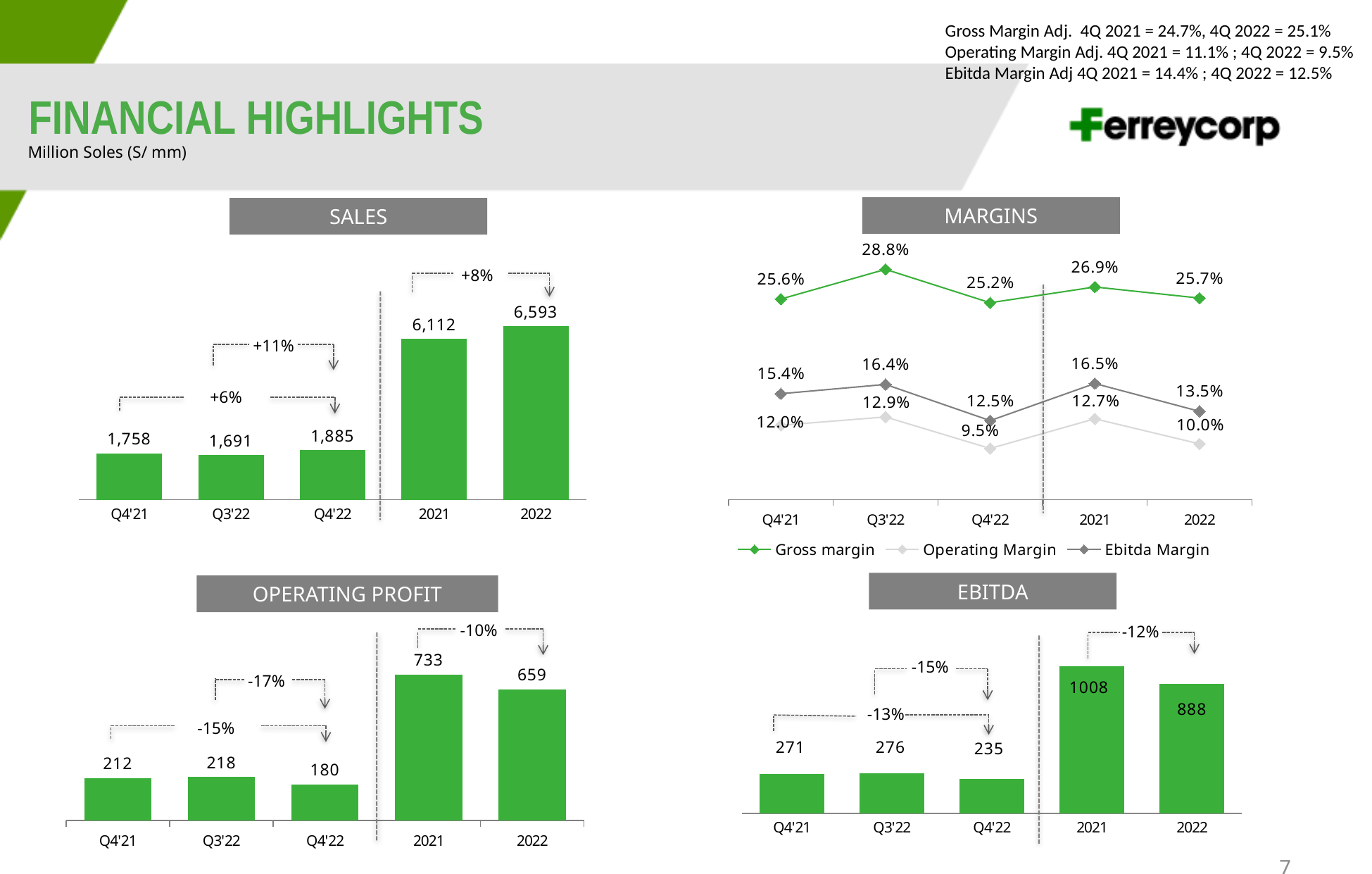
In the OPERATING PROFIT chart, what is the value for Q4'22? 180 In the EBITDA chart, what is the value for 2021? 1008 In the OPERATING PROFIT chart, which is larger, the value for 2021 or 2022? 2021 What kind of chart is the MARGINS chart? Line chart In the SALES chart, what is the value for 2022? 6,593 In the MARGINS chart, what is the Gross margin for Q3'22? 28.8% How many categories are shown on the x axis of the EBITDA chart? 5 In the MARGINS chart, what is the Operating Margin for Q4'22? 9.5% In the SALES chart, what is the difference between the 2022 and 2021 values? 481 How many series does the legend of the MARGINS chart list? 3 In the EBITDA chart, what is the difference between the Q3'22 and Q4'22 values? 41 In the SALES chart, which of the three quarters shown has the lowest sales? Q3'22